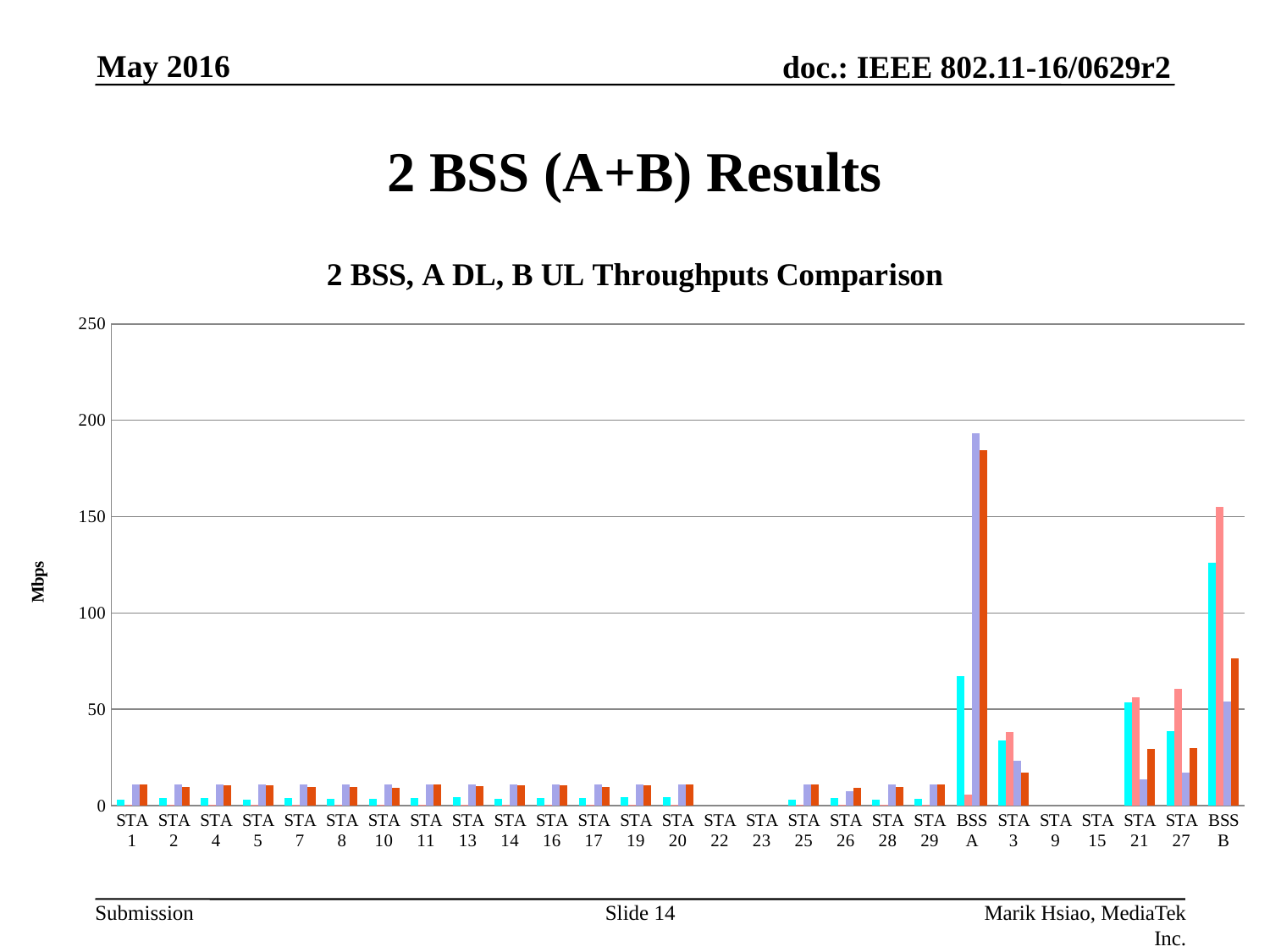
Is the cyan bar for BSS B greater or less than 100? greater Is the orange bar for BSS B greater or less than 100? less Which has the taller bars, STA 21 or STA 2? STA 21 What is the title of the chart? 2 BSS, A DL, B UL Throughputs Comparison What type of chart is shown on the slide? bar chart Which has the taller bars, BSS A or STA 3? BSS A Which category has the tallest bar in the chart? BSS A Is the tallest bar for BSS A greater or less than 150? greater How many categories are shown along the x axis of the chart? 27 What is the label on the vertical axis of the chart? Mbps